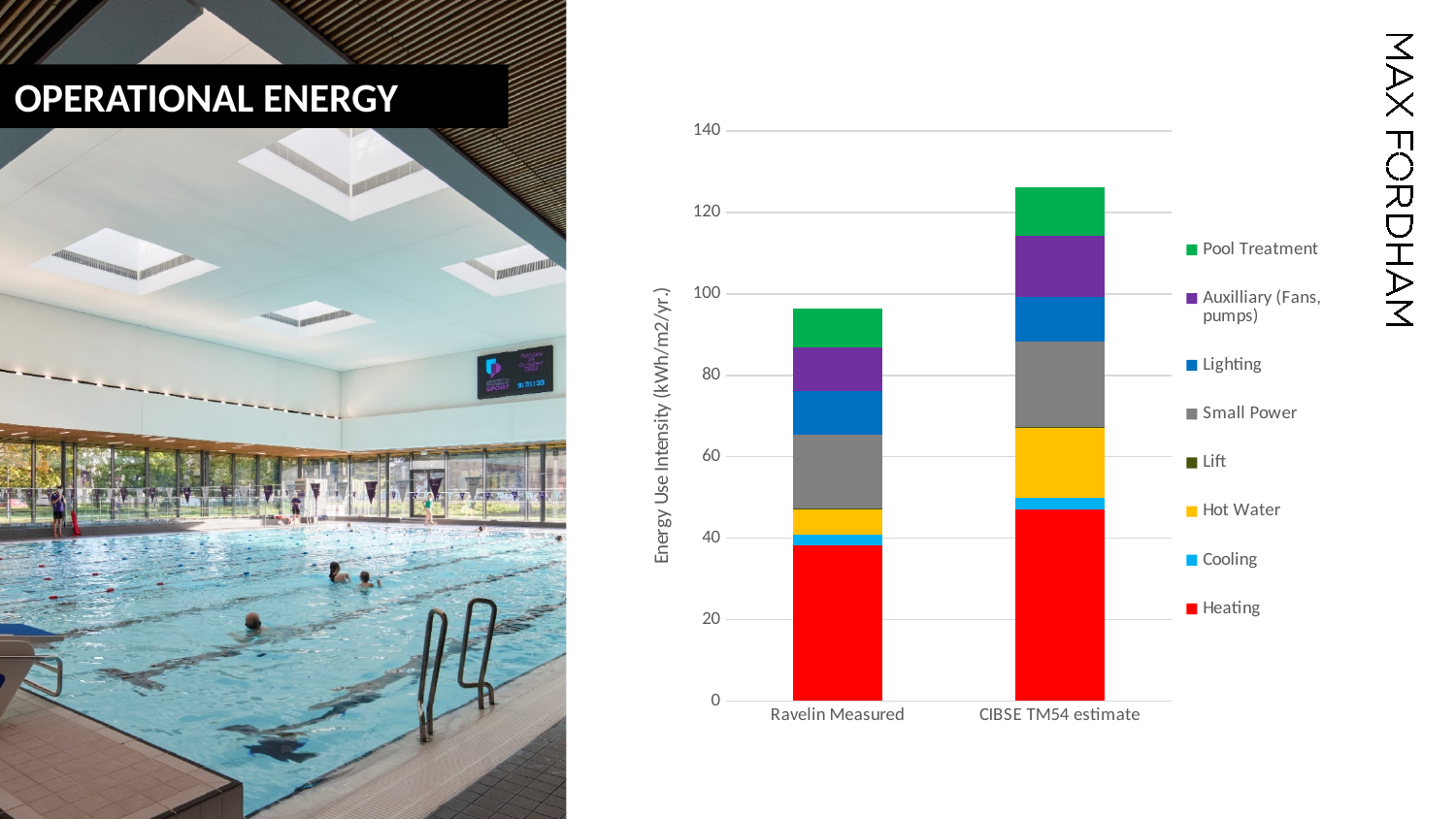
Is the Heating segment of the CIBSE TM54 estimate bar greater or less than 40? greater Which series is shown in red in the legend? Heating How many bars (categories) are plotted on the chart? 2 Which category has the lower total energy use intensity? Ravelin Measured How many series does the chart legend list? 8 What is the label of the vertical axis? Energy Use Intensity (kWh/m2/yr.) Which bar is taller overall, Ravelin Measured or CIBSE TM54 estimate? CIBSE TM54 estimate What kind of chart is shown on the slide? stacked bar chart Is the total for the Ravelin Measured bar greater or less than 80? greater Is the total for the CIBSE TM54 estimate bar greater or less than 140? less